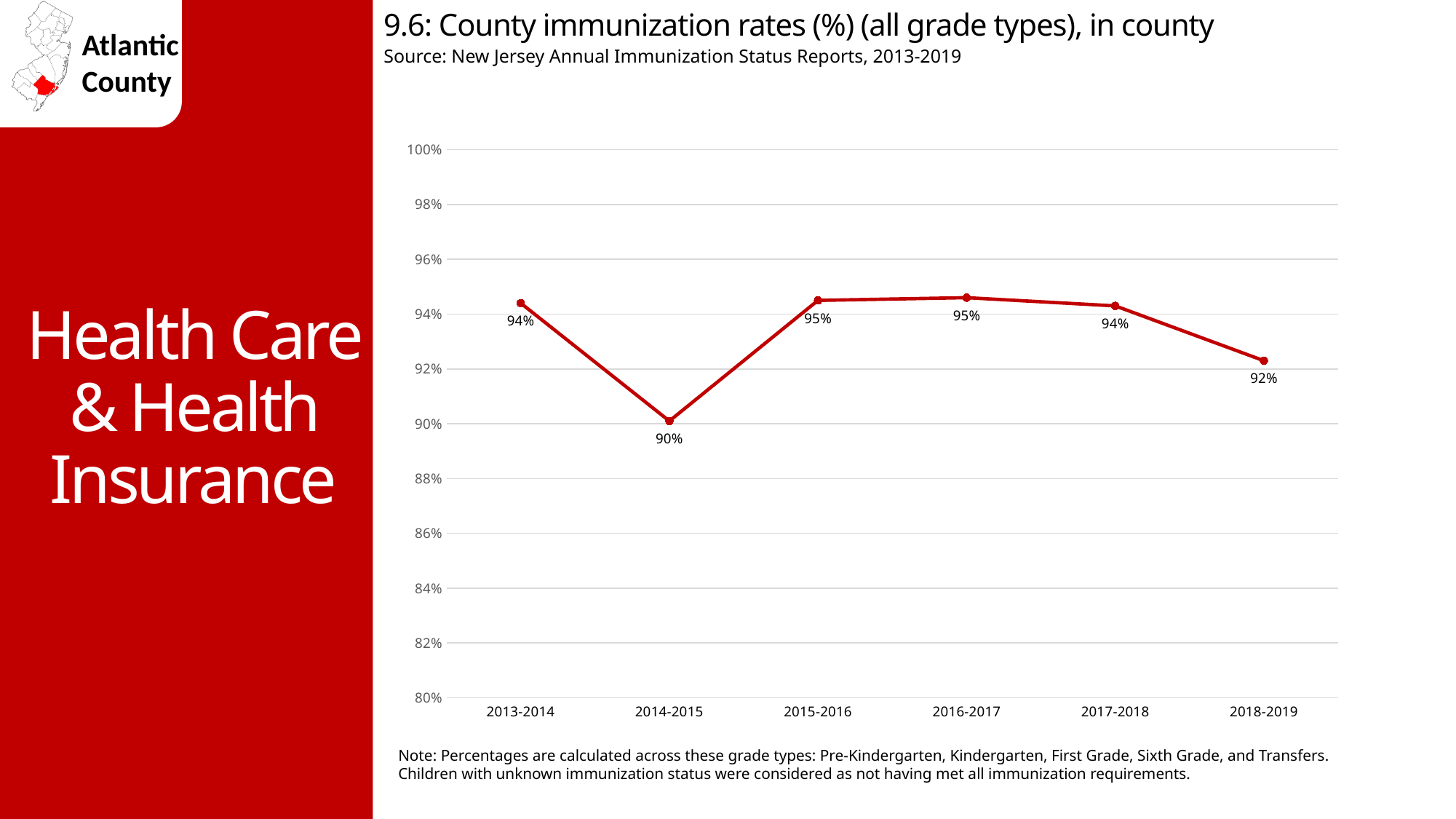
What was the county immunization rate in 2018-2019? 92% Which school year had the lowest immunization rate? 2014-2015 Do the immunization rates rise or fall from 2016-2017 to 2018-2019? Fall What is the difference between the immunization rates in 2013-2014 and 2014-2015? 4 percentage points What is the source cited for the chart data? New Jersey Annual Immunization Status Reports, 2013-2019 What was the county immunization rate in 2014-2015? 90% Which year had a higher immunization rate, 2014-2015 or 2018-2019? 2018-2019 How many school years are plotted on the chart? 6 What was the county immunization rate in 2013-2014? 94% What kind of chart is shown on the slide? Line chart Is the immunization rate for 2014-2015 greater or less than 92%? less Is the immunization rate for 2018-2019 greater or less than 90%? greater